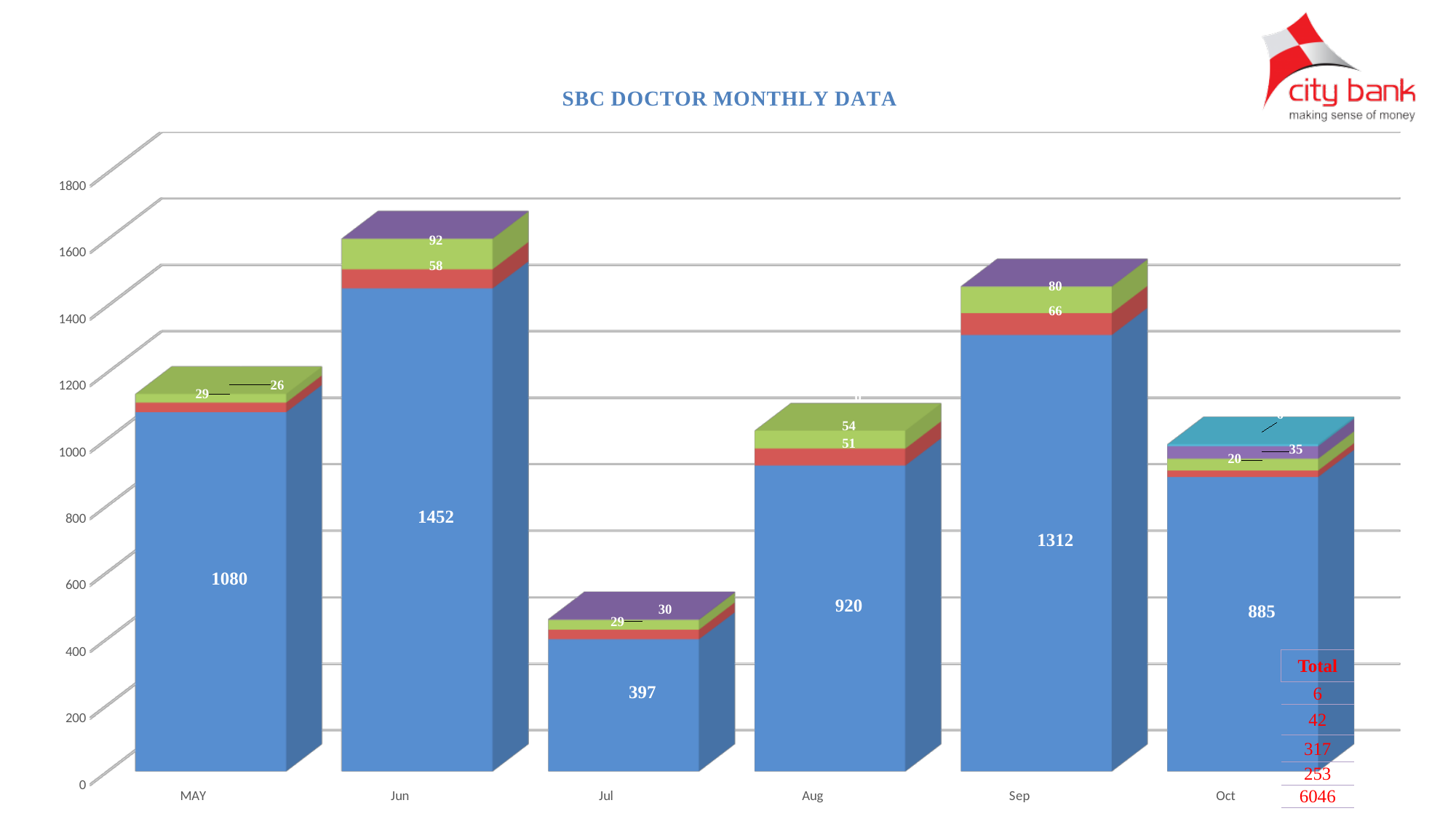
Which month has the larger blue segment value, Aug or Oct? Aug Which month has the lowest value for the blue segment? Jul What is the value of the red segment for Aug? 51 What is the title of the chart? SBC DOCTOR MONTHLY DATA How many months are shown on the x axis of the chart? 6 Which month has the highest value for the blue segment? Jun What is the value of the blue segment for Oct? 885 Is the total height of the Jul bar greater or less than 600? less What is the value of the green segment for Sep? 80 What kind of chart is shown on the slide? bar chart What is the value of the blue segment for Jun? 1452 What is the difference between the blue segment values for Jun and Sep? 140